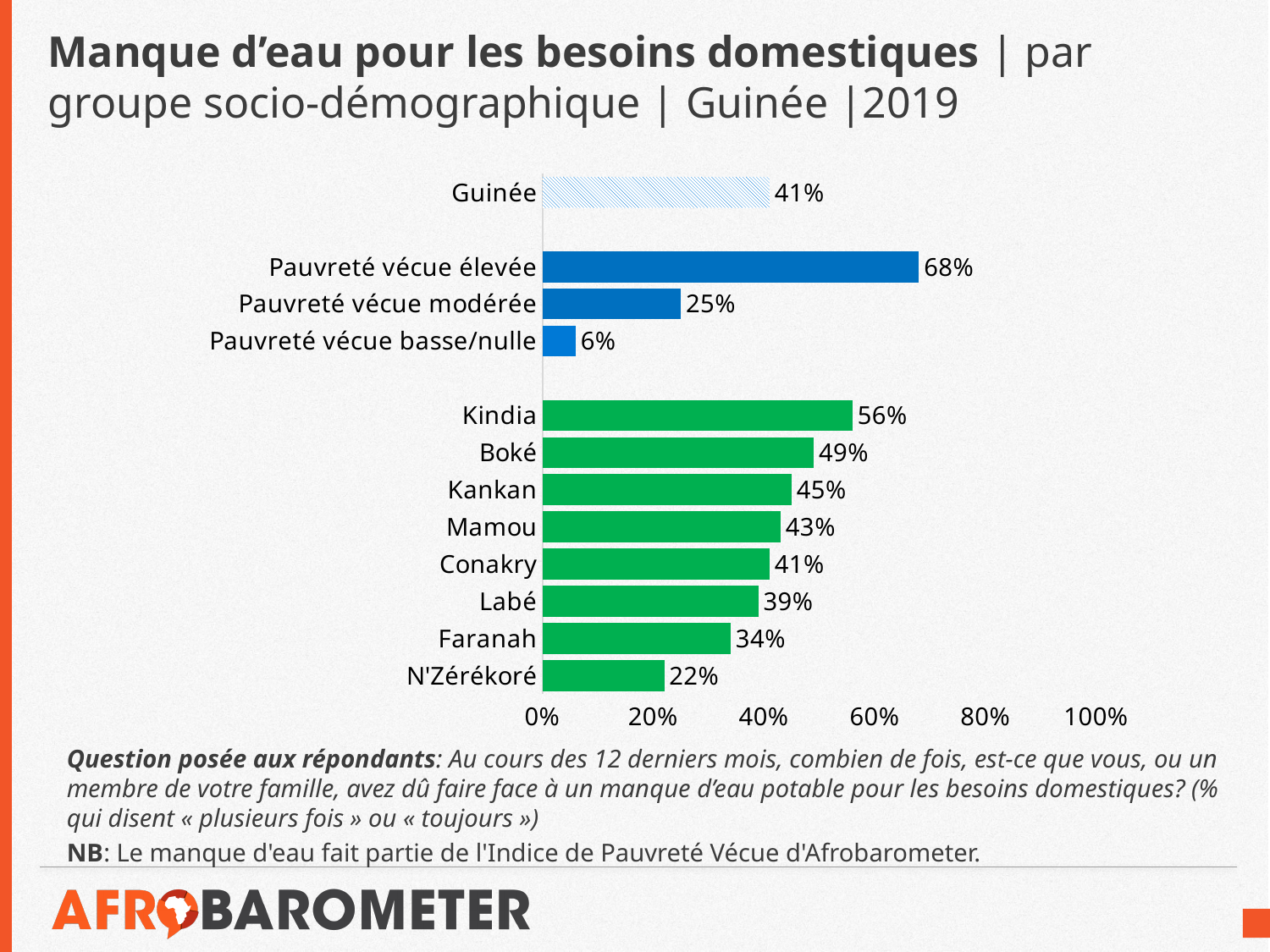
How many categories are shown on the chart? 12 Which category has the lowest value on the chart? Pauvreté vécue basse/nulle What is the value for Pauvreté vécue élevée? 68% Which category has the highest value on the chart? Pauvreté vécue élevée What is the difference between the values for Kindia and N'Zérékoré? 34 percentage points What kind of chart is shown on the slide? Bar chart Which has a larger value, Boké or Mamou? Boké What is the value for Guinée? 41% What is the value for N'Zérékoré? 22% Which region has the highest value among the regions shown? Kindia What is the value for Kankan? 45% What is the difference between the values for Pauvreté vécue élevée and Pauvreté vécue modérée? 43 percentage points